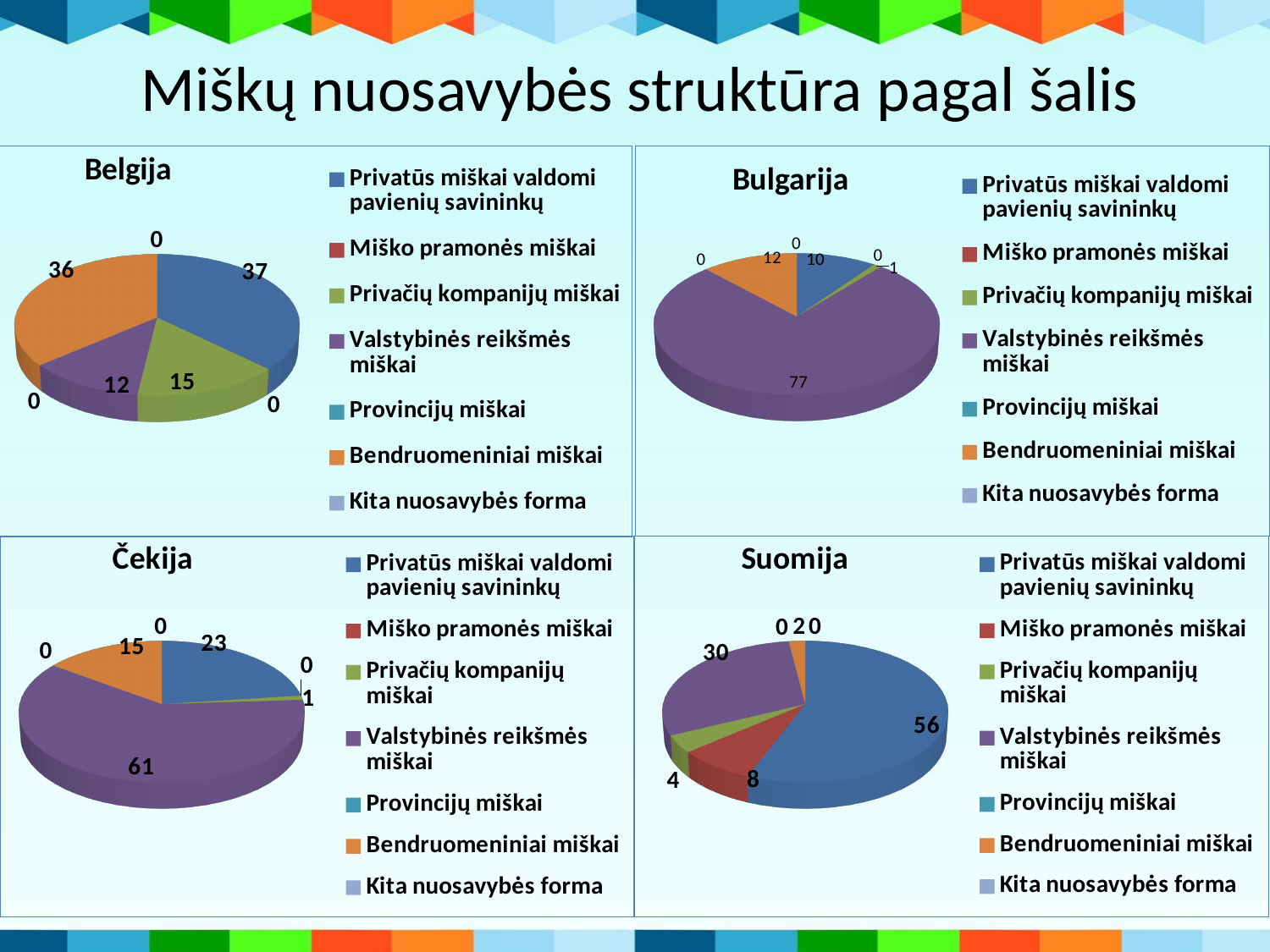
In the Belgija chart, what is the value for Privatūs miškai valdomi pavienių savininkų? 37 In the Suomija chart, which is larger: Valstybinės reikšmės miškai or Privačių kompanijų miškai? Valstybinės reikšmės miškai In the Suomija chart, what is the value for Miško pramonės miškai? 8 What type of chart is the Čekija chart? Pie chart In the Bulgarija chart, which category has the largest slice? Valstybinės reikšmės miškai In the Suomija chart, which category has the largest slice? Privatūs miškai valdomi pavienių savininkų How many entries does the legend of the Belgija chart list? 7 In the Čekija chart, what is the value for Bendruomeniniai miškai? 15 In the Čekija chart, what is the difference between Valstybinės reikšmės miškai and Privatūs miškai valdomi pavienių savininkų? 38 How many charts are shown on the slide? 4 In the Belgija chart, what is the value for Bendruomeniniai miškai? 36 In the Bulgarija chart, what is the value for Valstybinės reikšmės miškai? 77